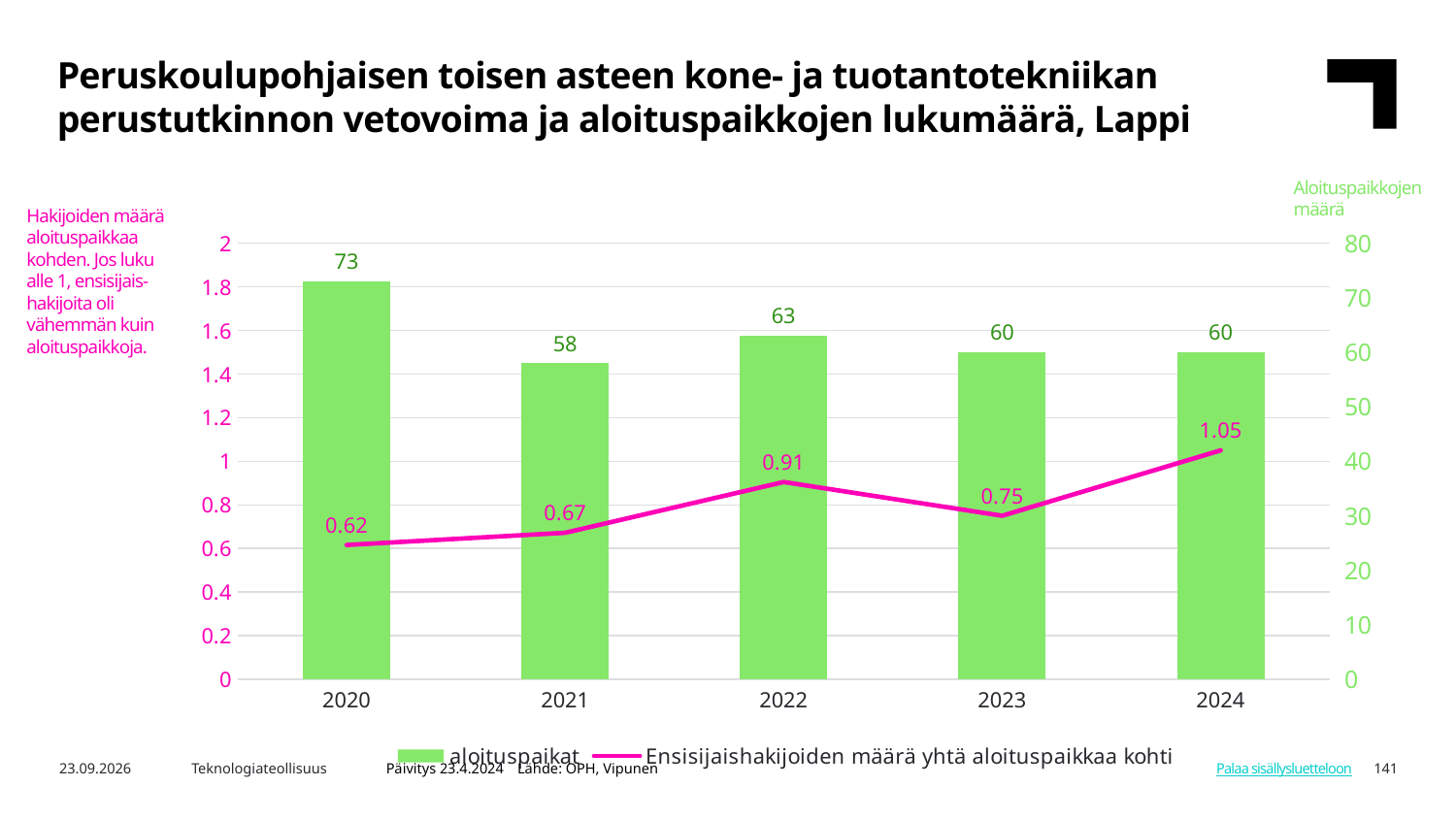
What is the value of aloituspaikat for 2020? 73 What is the value of aloituspaikat for 2021? 58 Which year has the lowest value of Ensisijaishakijoiden määrä yhtä aloituspaikkaa kohti? 2020 Is the value of Ensisijaishakijoiden määrä yhtä aloituspaikkaa kohti larger in 2023 or in 2024? 2024 What is the value of Ensisijaishakijoiden määrä yhtä aloituspaikkaa kohti for 2022? 0.91 What colour are the aloituspaikat bars? Green Which year has the highest value of aloituspaikat? 2020 What kind of chart is shown on the slide? Combined bar and line chart How many series does the legend list? 2 What is the difference between the aloituspaikat values for 2020 and 2021? 15 How many years are shown on the x axis? 5 Does the value of Ensisijaishakijoiden määrä yhtä aloituspaikkaa kohti rise or fall from 2023 to 2024? Rise